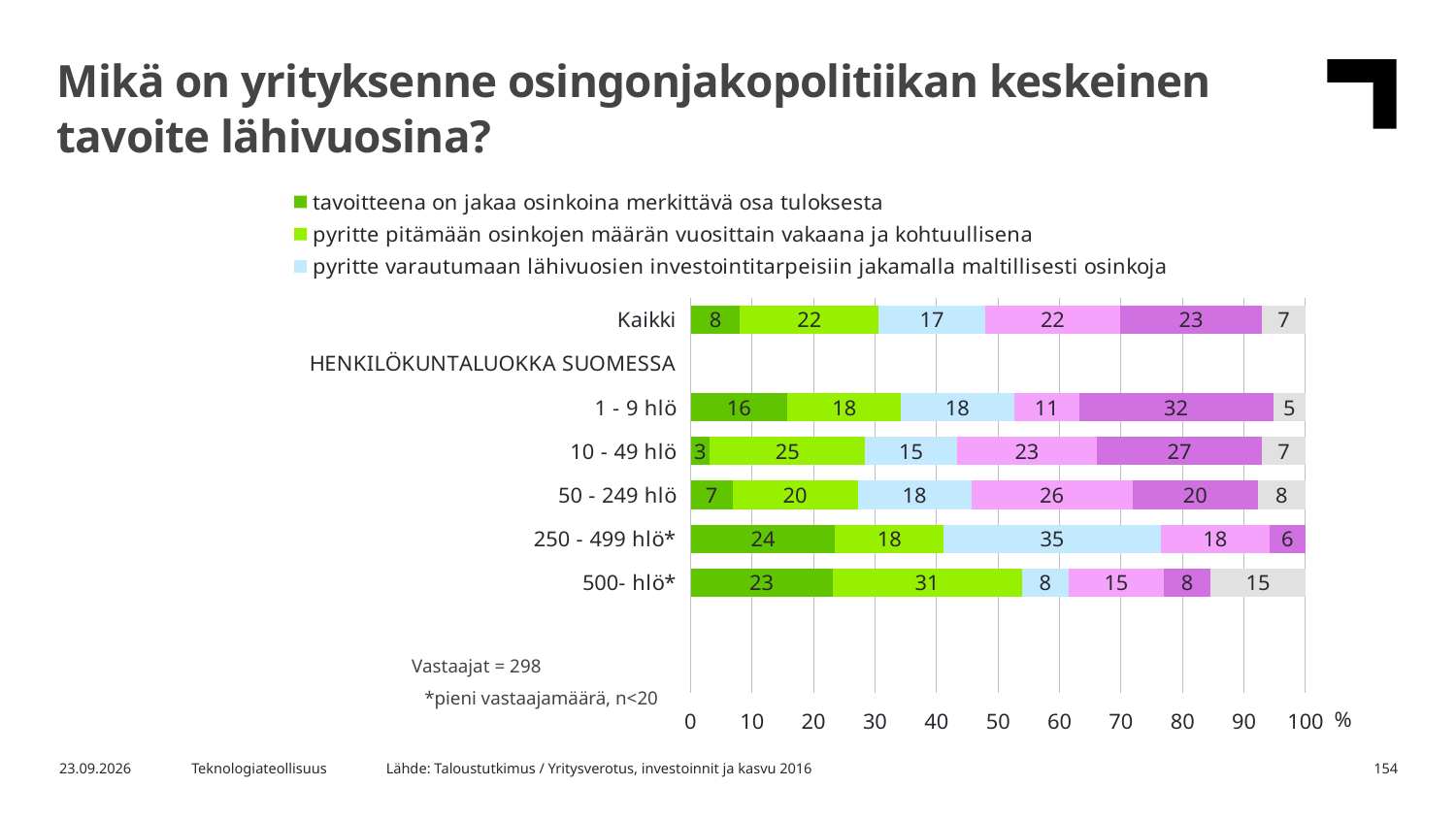
Which category has the lowest value in the series "tavoitteena on jakaa osinkoina merkittävä osa tuloksesta"? 10 - 49 hlö In the series "pyritte varautumaan lähivuosien investointitarpeisiin jakamalla maltillisesti osinkoja", which is larger: 50 - 249 hlö or 10 - 49 hlö? 50 - 249 hlö What is the title of the slide? Mikä on yrityksenne osingonjakopolitiikan keskeinen tavoite lähivuosina? What is the difference between 10 - 49 hlö and 1 - 9 hlö in the series "pyritte pitämään osinkojen määrän vuosittain vakaana ja kohtuullisena"? 7 What is the value for 500- hlö* in the series "pyritte pitämään osinkojen määrän vuosittain vakaana ja kohtuullisena"? 31 What is the total of the stacked bar for 1 - 9 hlö? 100 How many categories have bars plotted in the chart? 6 How many series does the legend list? 3 What is the value for Kaikki in the series "tavoitteena on jakaa osinkoina merkittävä osa tuloksesta"? 8 What kind of chart is shown on the slide? Stacked bar chart Which category has the highest value in the series "tavoitteena on jakaa osinkoina merkittävä osa tuloksesta"? 250 - 499 hlö* What is the value for 250 - 499 hlö* in the series "pyritte varautumaan lähivuosien investointitarpeisiin jakamalla maltillisesti osinkoja"? 35